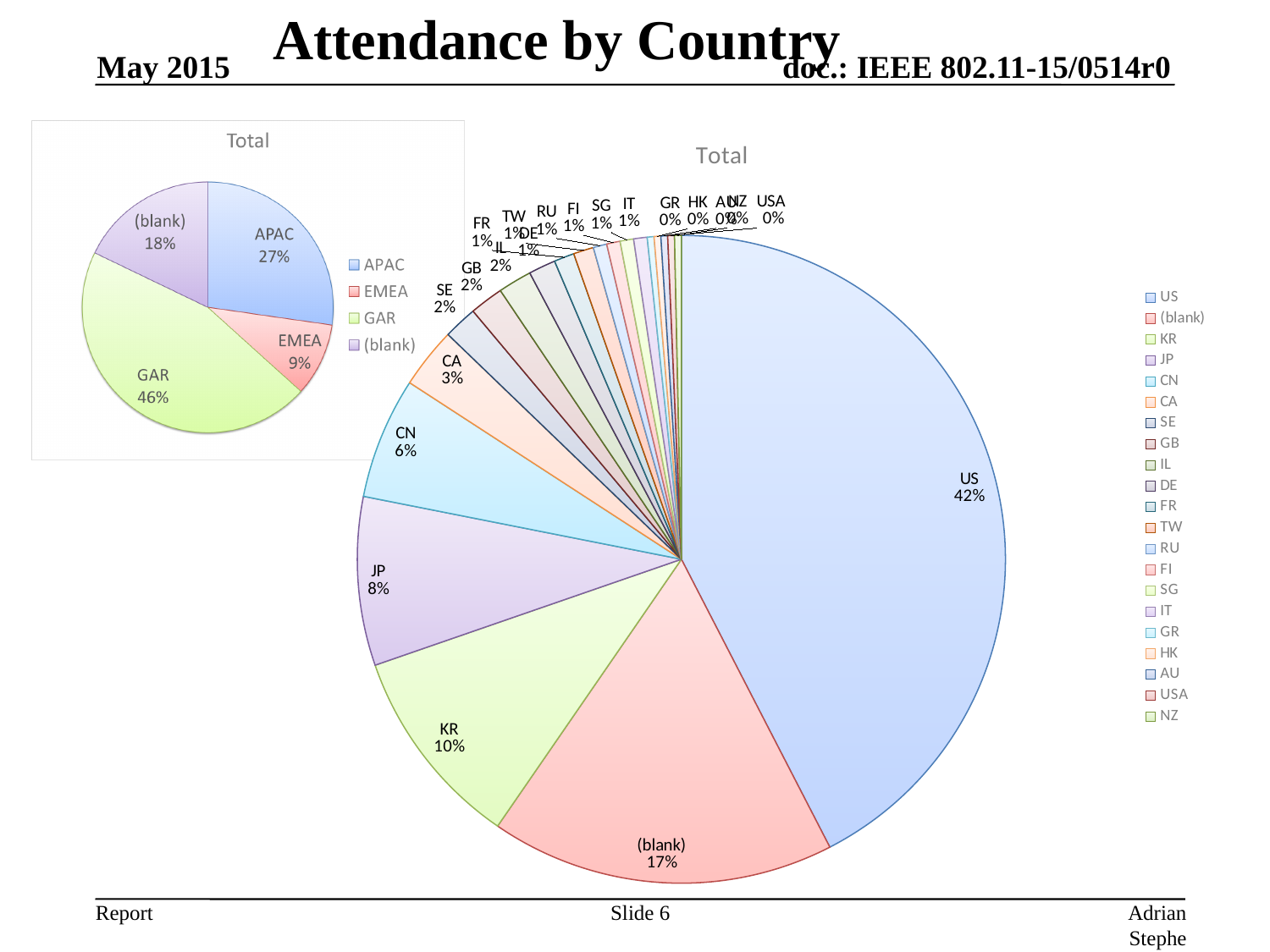
In the large pie chart on the right, which is larger, the share for JP or the share for CN? JP In the small pie chart on the left, which region has the smallest share? EMEA In the small pie chart on the left, what share does GAR have? 46% How many entries does the legend of the large pie chart on the right list? 21 In the small pie chart on the left, what share does APAC have? 27% In the small pie chart on the left, which region has the largest share? GAR How many entries does the legend of the small pie chart on the left list? 4 In the large pie chart on the right, what share does KR have? 10% What kind of chart is the small chart on the left of the slide? pie chart In the large pie chart on the right, what share does US have? 42% In the large pie chart on the right, what is the difference between the US share and the (blank) share? 25% In the small pie chart on the left, what is the difference between the GAR share and the (blank) share? 28%